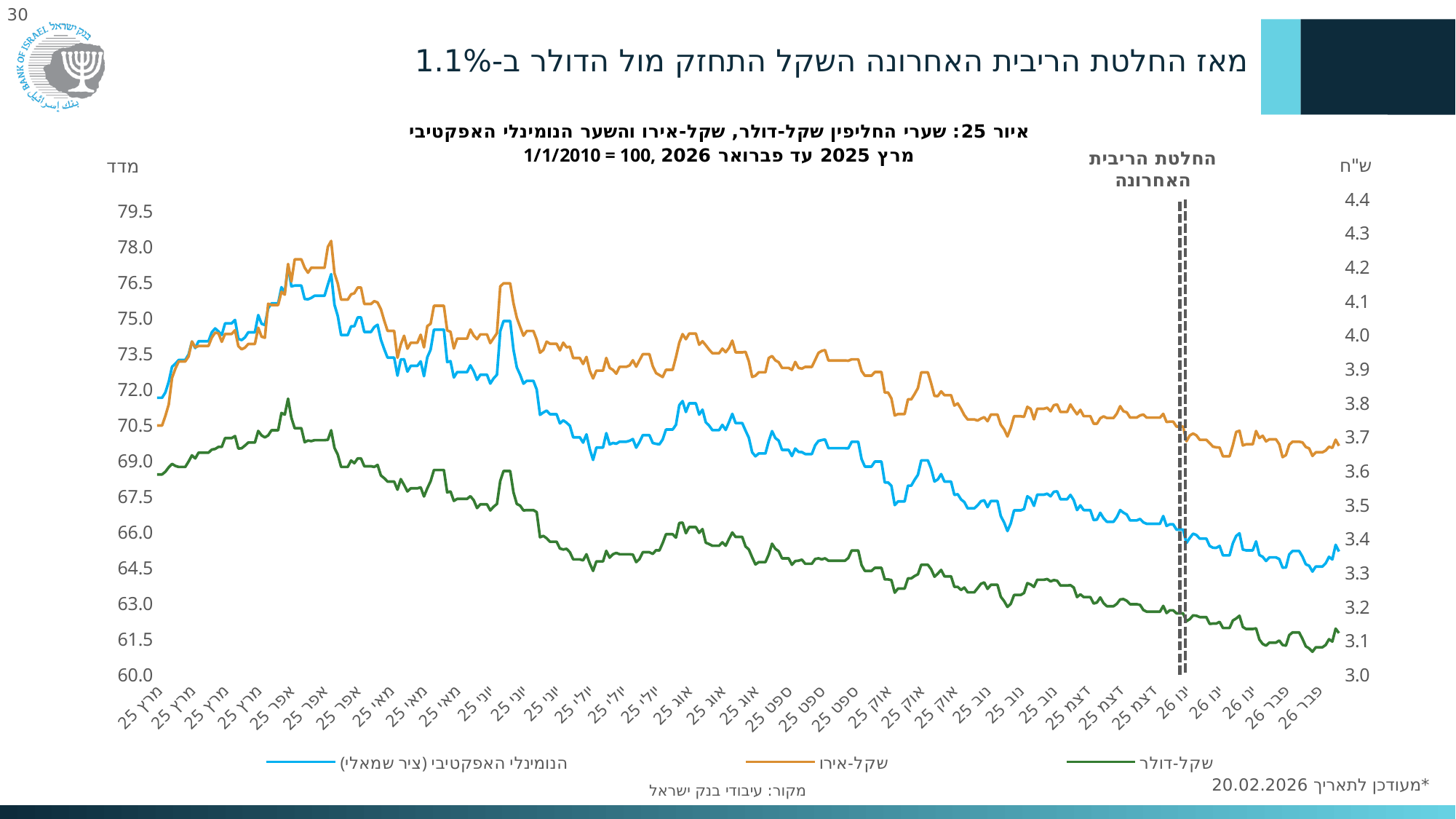
Which series is plotted on the left axis according to the legend? הנומינלי האפקטיבי (ציר שמאלי) Which series is higher throughout the chart, שקל-אירו or שקל-דולר? שקל-אירו What kind of chart is shown on the slide? line chart Is the value of the שקל-דולר series at the start of the chart (מרץ 25) greater or less than 3.5 on the right axis? greater Is the value of the הנומינלי האפקטיבי series at the end of the chart (פבר 26) greater or less than 67.5 on the left axis? less What is the highest tick value shown on the right axis? 4.4 Is the value of the שקל-דולר series at the end of the chart (פבר 26) greater or less than 3.2 on the right axis? less How many series does the legend list? 3 Does the שקל-אירו series rise or fall overall from מרץ 25 to פבר 26? fall What does the vertical dashed line on the chart mark? החלטת הריבית האחרונה Does the שקל-דולר series rise or fall overall from מרץ 25 to פבר 26? fall